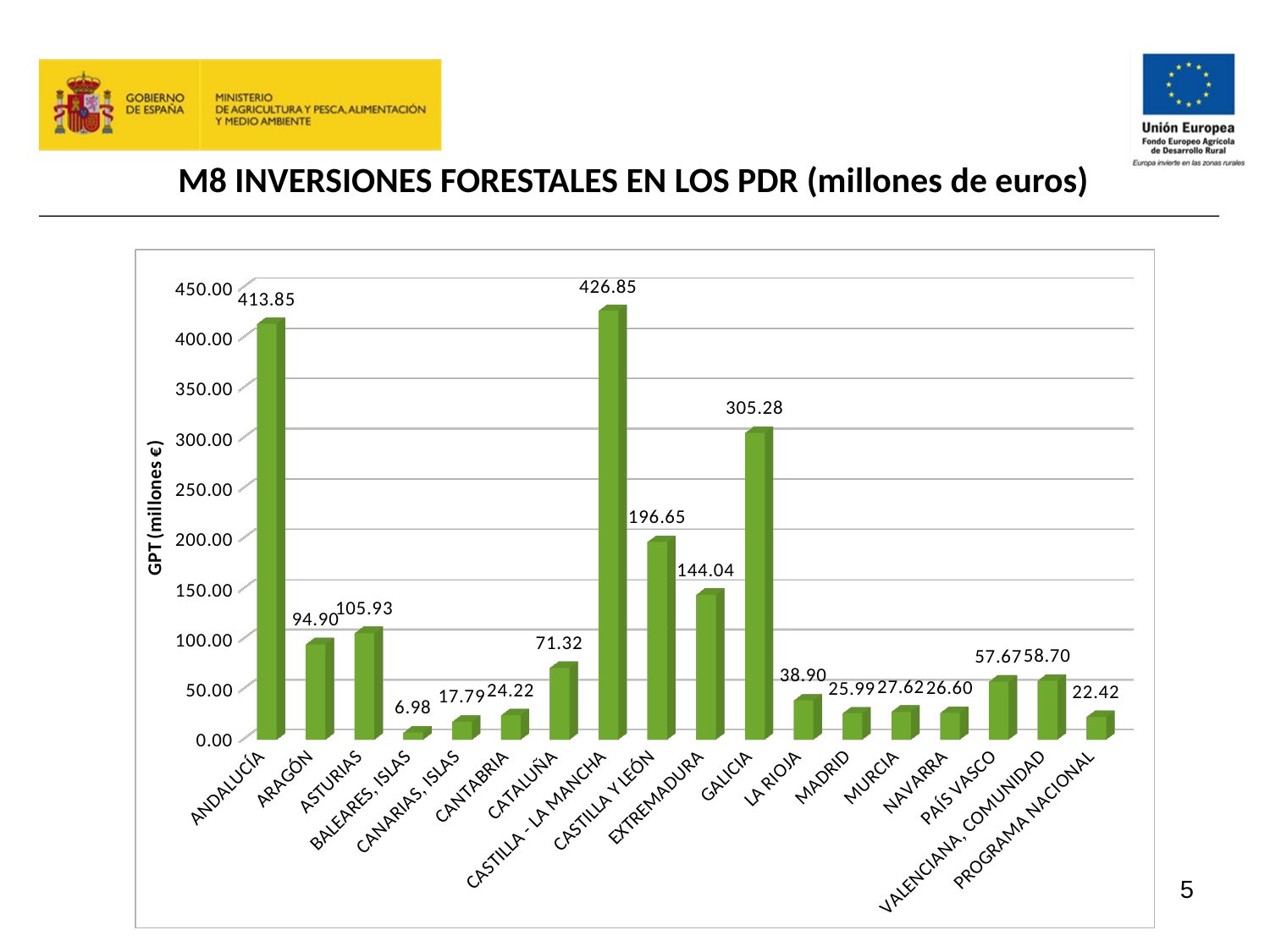
Is the value for GALICIA greater or less than 300.00? greater What is the difference between the values for CASTILLA Y LEÓN and EXTREMADURA? 52.61 What is the value for CATALUÑA? 71.32 Which category has the lowest value? BALEARES, ISLAS What is the value for EXTREMADURA? 144.04 How many categories are shown on the x axis? 18 Which category has the highest value? CASTILLA - LA MANCHA What kind of chart is shown on the slide? Bar chart What is the value for GALICIA? 305.28 Which is larger, the value for ARAGÓN or the value for ASTURIAS? ASTURIAS What is the label of the vertical axis? GPT (millones €) What is the difference between the values for CASTILLA - LA MANCHA and ANDALUCÍA? 13.00